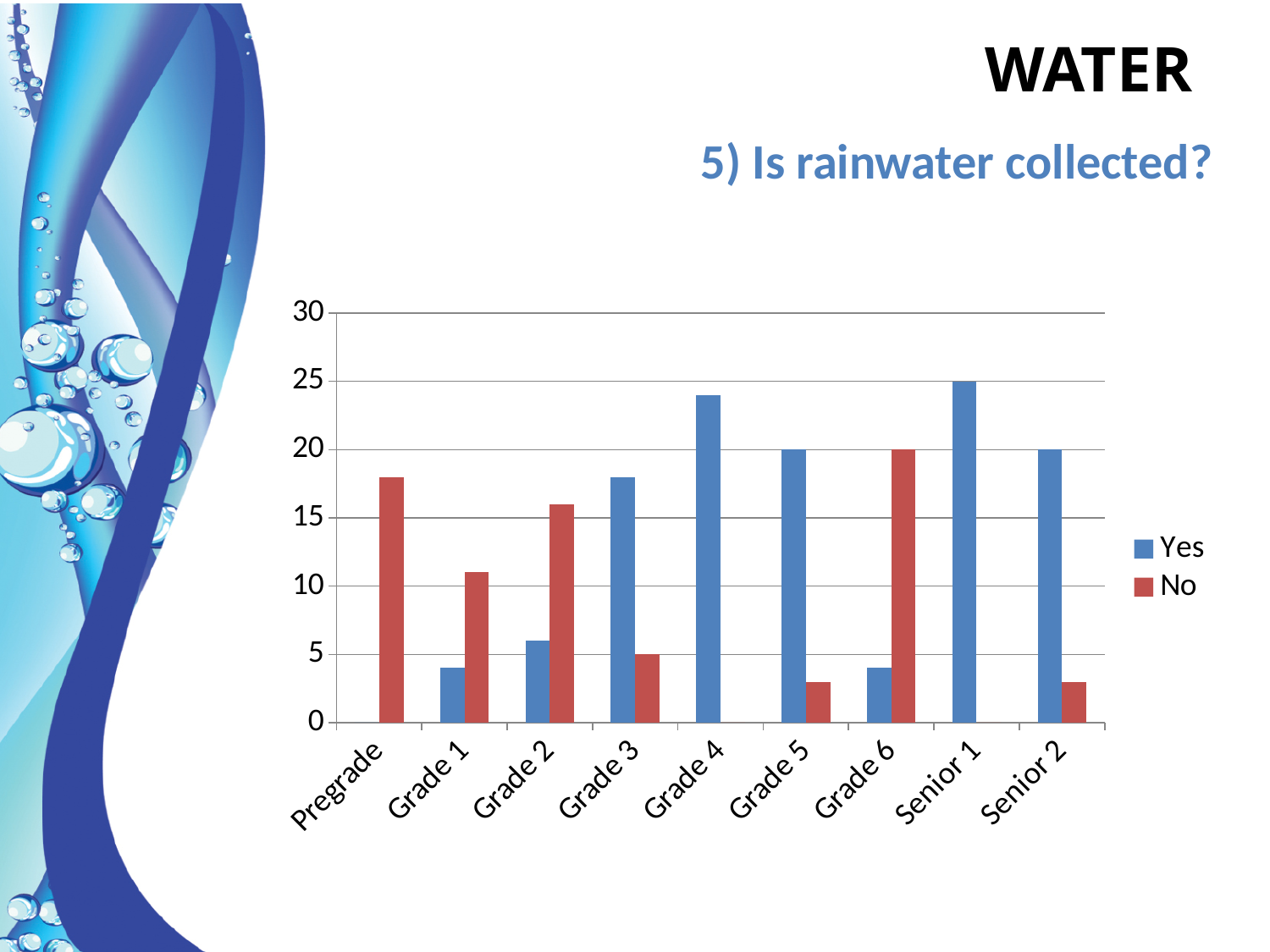
What is the Yes value for Grade 5? 20 Is the Yes value for Grade 1 greater or less than 5? less For Grade 3, which is larger, the Yes value or the No value? Yes Is the Yes value for Grade 4 greater or less than 20? greater Is the No value for Pregrade greater or less than 15? greater How many categories are shown on the x axis? 9 Which category has the highest Yes value? Senior 1 What kind of chart is shown on the slide? bar chart For Grade 2, which is larger, the Yes value or the No value? No How many series does the legend list? 2 What are the two entries in the chart's legend? Yes and No Which category has the highest No value? Grade 6